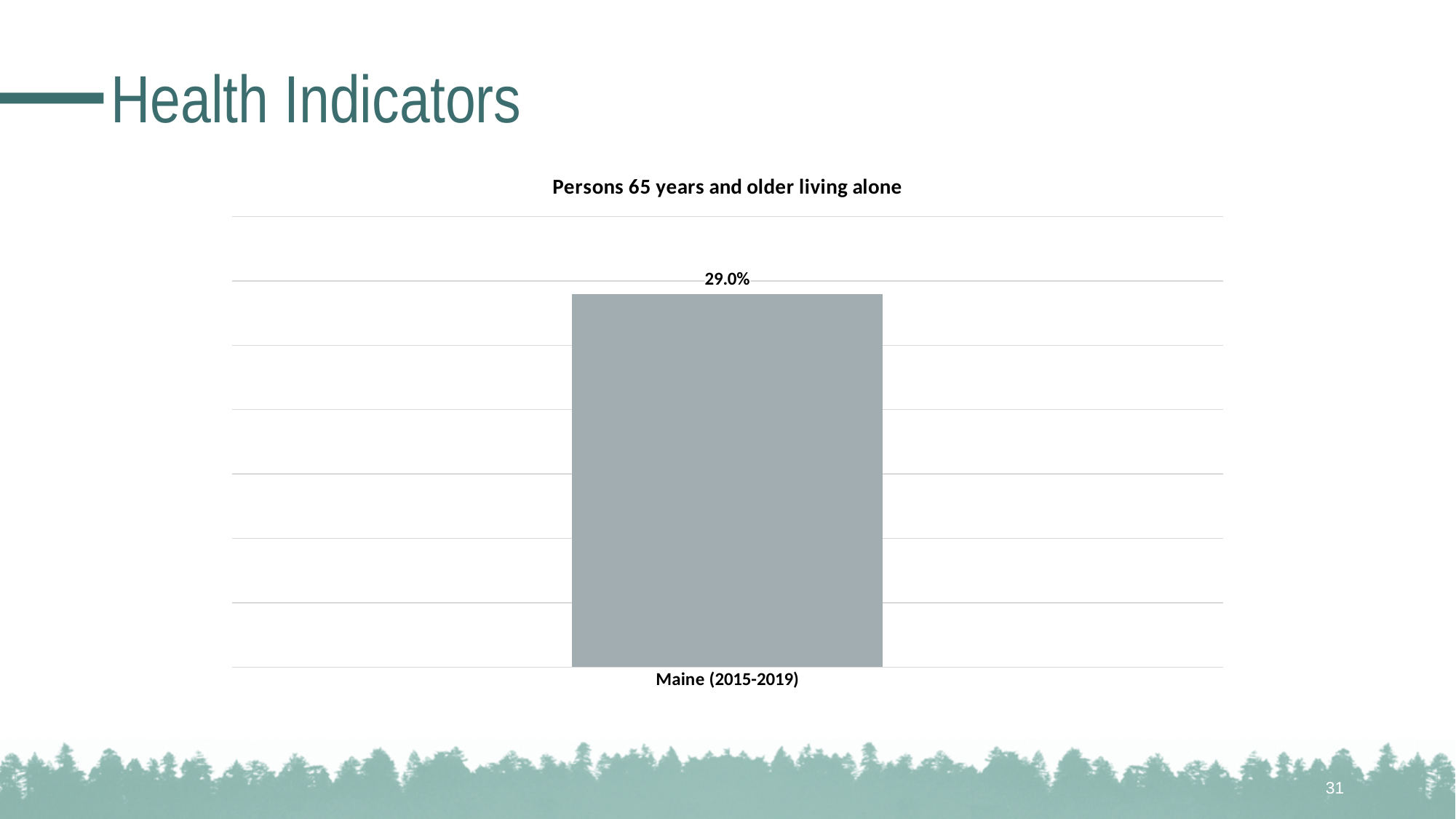
How many bars are plotted in the chart? 1 What is the title of the chart? Persons 65 years and older living alone What is the value shown for Maine (2015-2019) in the chart? 29.0% What kind of chart is shown on the slide? bar chart What percentage of persons 65 years and older in Maine (2015-2019) live alone, according to the chart? 29.0% What is the category label on the x axis of the chart? Maine (2015-2019)